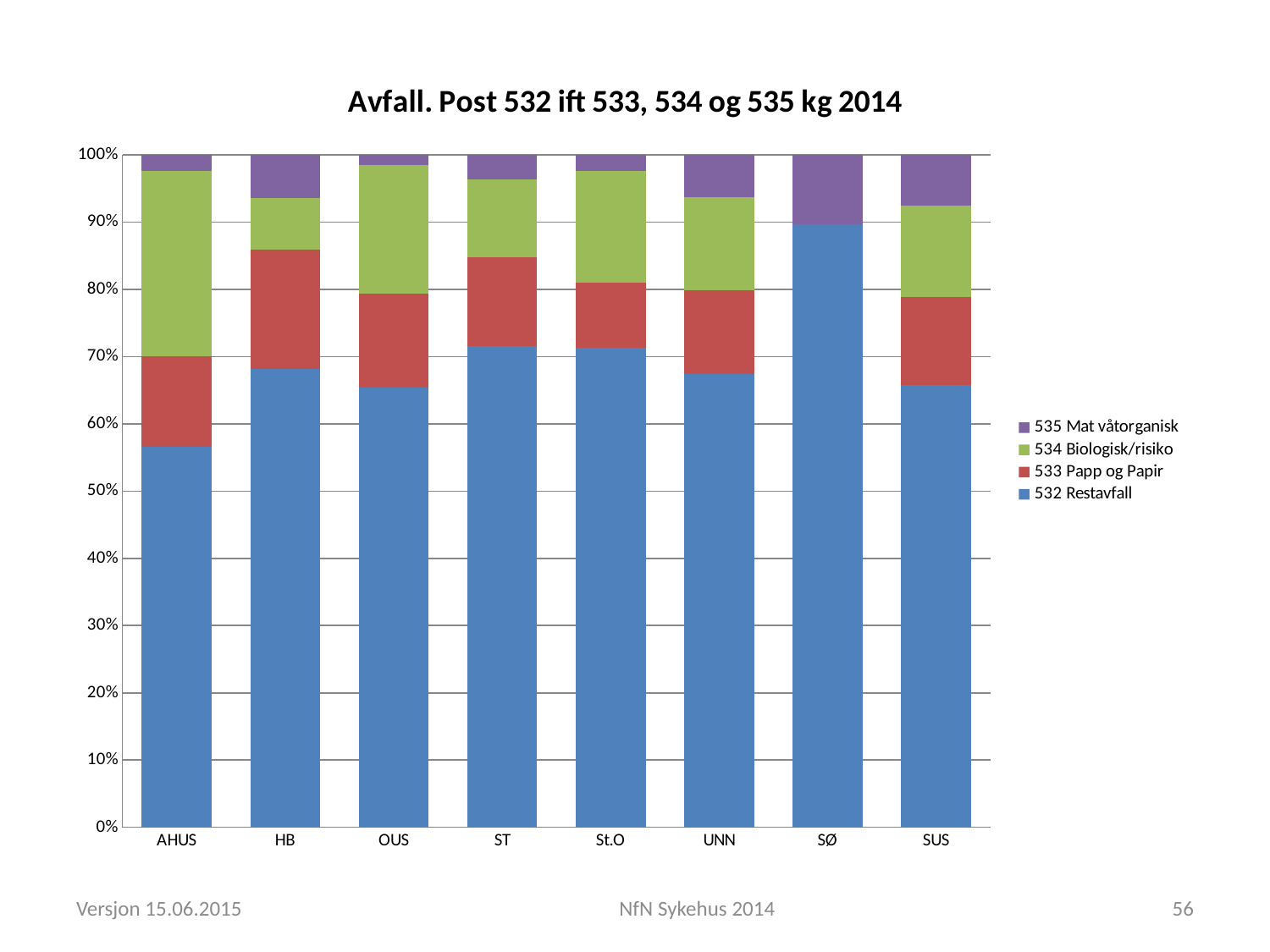
Is the share of 532 Restavfall for HB greater or less than 60%? greater Which category has the largest share of 534 Biologisk/risiko? AHUS Is the share of 532 Restavfall for SØ greater or less than 80%? greater Which colour represents 532 Restavfall in the chart? Blue How many series does the legend list? 4 What kind of chart is shown on the slide? Stacked bar chart How many categories (hospitals) are shown on the x axis? 8 Which category has the largest share of 532 Restavfall? SØ Which category has the largest share of 535 Mat våtorganisk? SØ What is the title of the chart? Avfall. Post 532 ift 533, 534 og 535 kg 2014 Which category has the smallest share of 532 Restavfall? AHUS Is the share of 532 Restavfall for AHUS greater or less than 60%? less